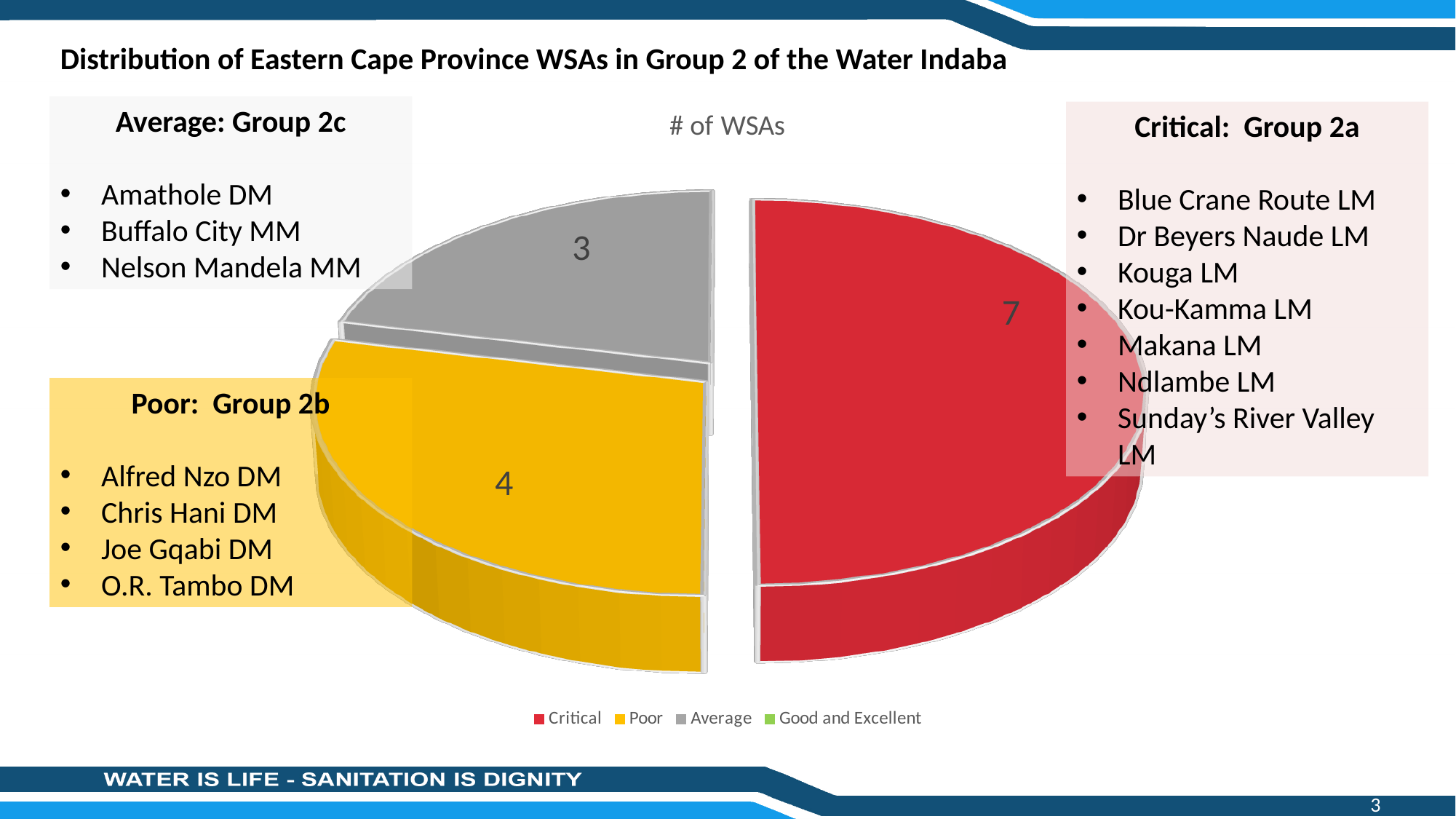
Which is larger, the Poor slice or the Average slice? Poor How many entries does the chart legend list? 4 How many WSAs are in the Critical category? 7 Which category has the largest number of WSAs? Critical What is the title of the chart? # of WSAs Which of the visible slices has the smallest number of WSAs? Average What is the difference between the number of Critical WSAs and Poor WSAs? 3 What is the difference between the number of Poor WSAs and Average WSAs? 1 What colour represents the Critical category in the pie chart? Red How many WSAs are in the Poor category? 4 What type of chart is shown on the slide? Pie chart How many WSAs are in the Average category? 3